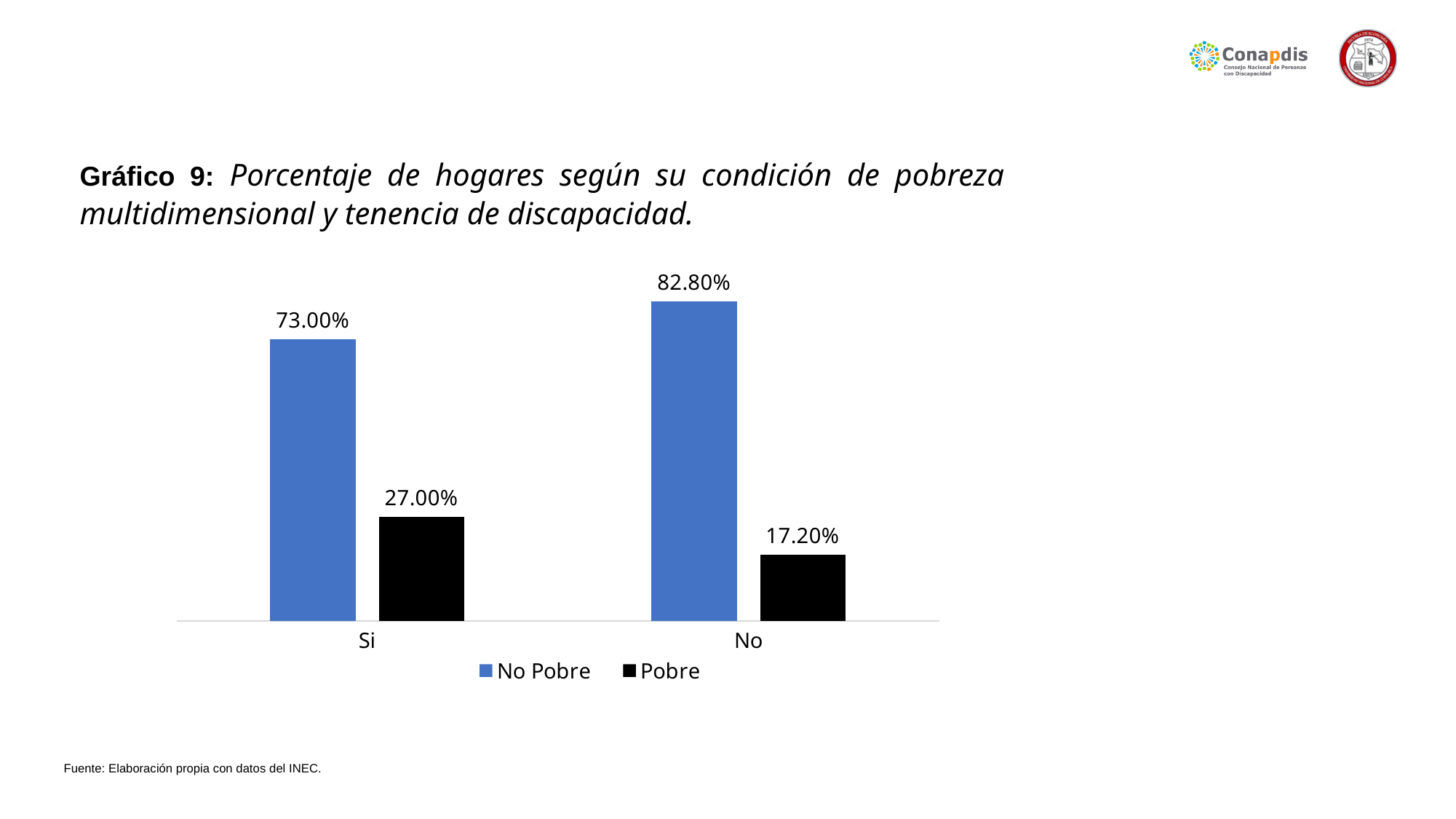
What is the value for Pobre in the Si category? 27.00% What is the value for Pobre in the No category? 17.20% What kind of chart is shown on the slide? Bar chart What is the value for No Pobre in the No category? 82.80% What is the difference between the No Pobre values for No and Si? 9.80% Which category has the highest No Pobre value? No How many categories are shown on the x axis? 2 Which is larger, the Pobre value for Si or the Pobre value for No? Si What is the difference between the Pobre values for Si and No? 9.80% What is the value for No Pobre in the Si category? 73.00% Which category has the lowest Pobre value? No How many series does the legend list? 2